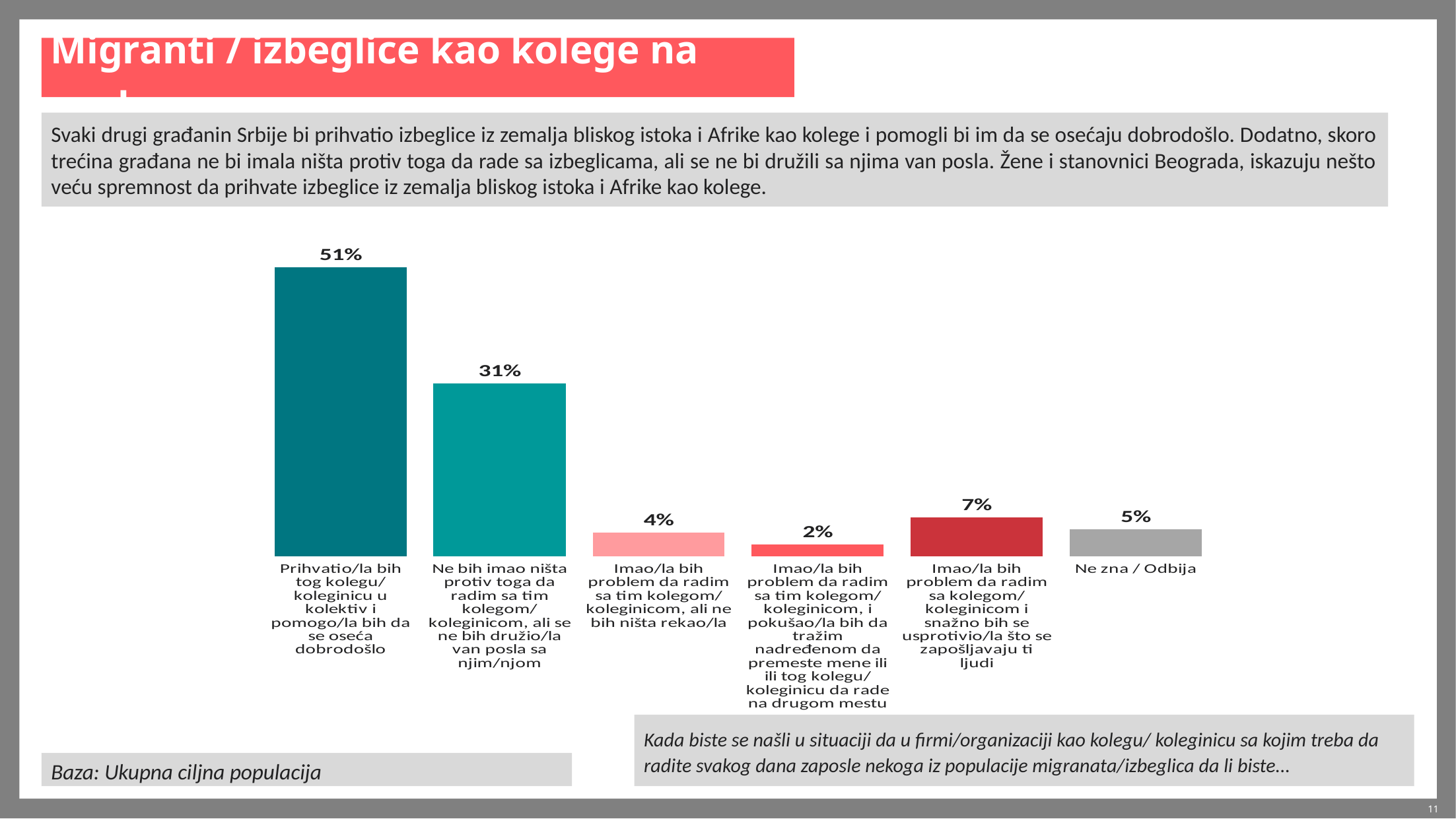
Which category has the lowest value? Imao/la bih problem da radim sa tim kolegom/ koleginicom, i pokušao/la bih da tražim nadređenom da premeste mene ili tog kolegu/ koleginicu da rade na drugom mestu Which is larger: the value for "Ne zna / Odbija" or the value for "Imao/la bih problem da radim sa tim kolegom/ koleginicom, ali ne bih ništa rekao/la"? Ne zna / Odbija What percentage of respondents chose "Ne zna / Odbija"? 5% What colour is the bar for "Ne zna / Odbija"? Grey What is the value for the category "Prihvatio/la bih tog kolegu/ koleginicu u kolektiv i pomogo/la bih da se oseća dobrodošlo"? 51% How many categories are shown in the chart? 6 What is the combined value of the two "Imao/la bih problem" categories with values 4% and 2%? 6% What is the value for "Ne bih imao ništa protiv toga da radim sa tim kolegom/ koleginicom, ali se ne bih družio/la van posla sa njim/njom"? 31% Which category has the highest value? Prihvatio/la bih tog kolegu/ koleginicu u kolektiv i pomogo/la bih da se oseća dobrodošlo What is the value for "Imao/la bih problem da radim sa kolegom/ koleginicom i snažno bih se usprotivio/la što se zapošljavaju ti ljudi"? 7% What is the difference between the two largest values, 51% and 31%? 20% What type of chart is shown on the slide? Bar chart